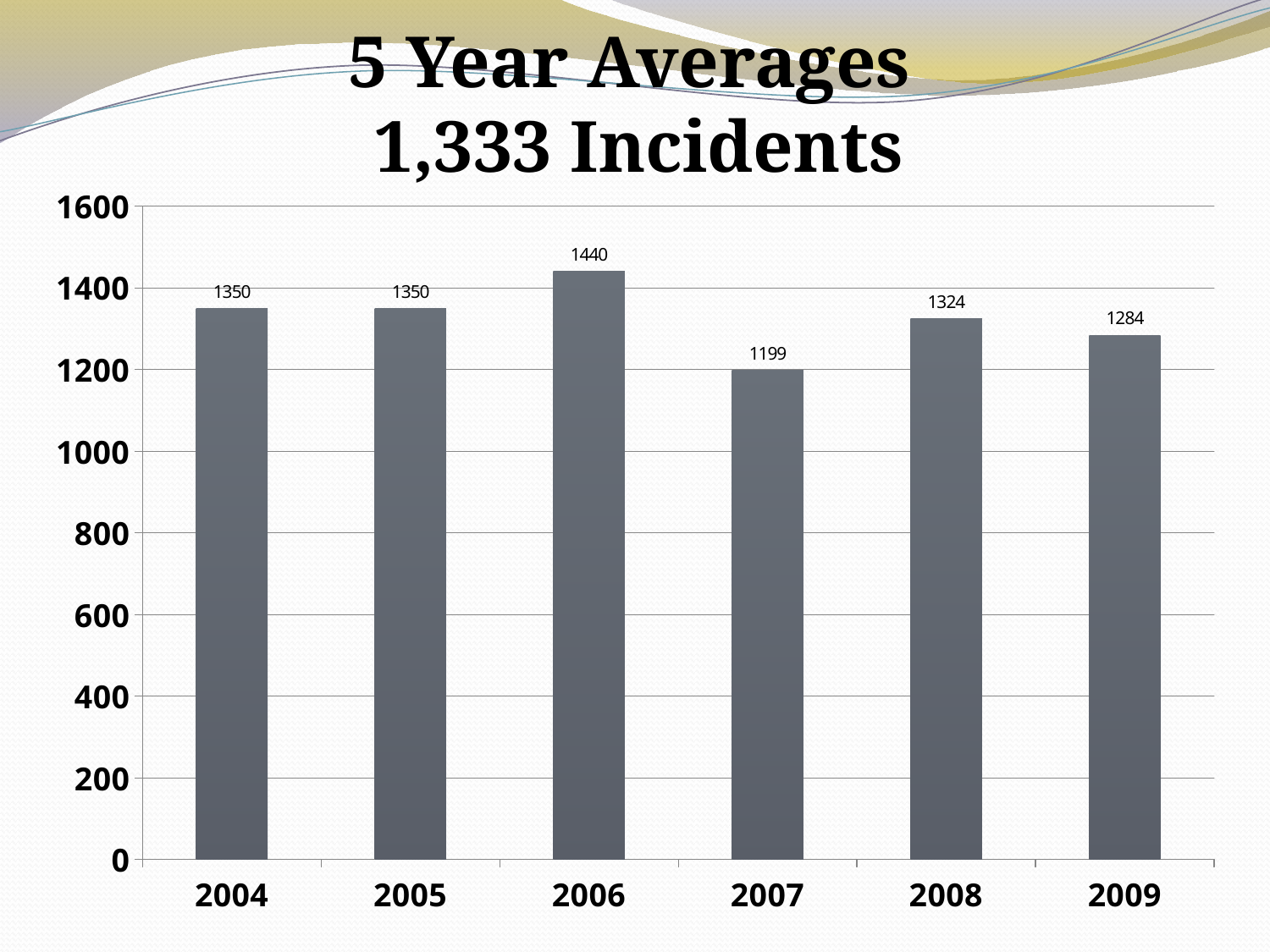
Which is larger, the value for 2008 or the value for 2009? 2008 Which year has the highest value? 2006 What is the value for 2008? 1324 What is the difference between the values for 2008 and 2009? 40 Which year has the lowest value? 2007 What is the value for 2009? 1284 What is the difference between the values for 2006 and 2007? 241 What is the value for 2007? 1199 What is the title of the slide? 5 Year Averages 1,333 Incidents What kind of chart is shown on the slide? bar chart How many years are shown on the x axis? 6 What is the value for 2006? 1440